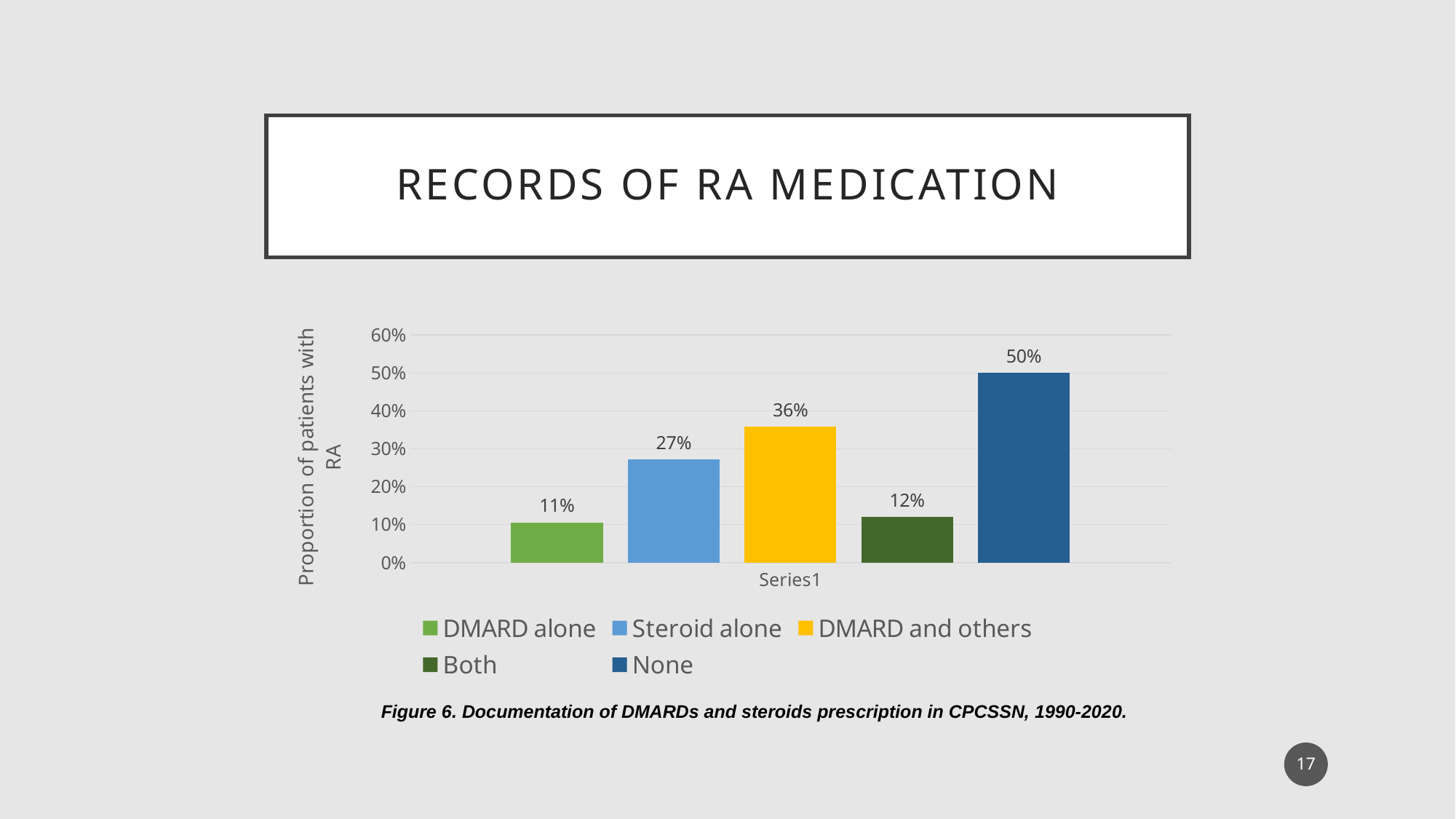
Which is larger, the value for Steroid alone or the value for Both? Steroid alone Which category has the highest value? None Which category has the lowest value? DMARD alone What is the value for DMARD alone? 11% What is the value for None? 50% What is the difference between the values for None and DMARD and others? 14% What is the value for DMARD and others? 36% How many bars are plotted in the chart? 5 What is the label on the vertical axis of the chart? Proportion of patients with RA What is the value for Steroid alone? 27% How many entries does the legend list? 5 What kind of chart is shown on the slide? Bar chart